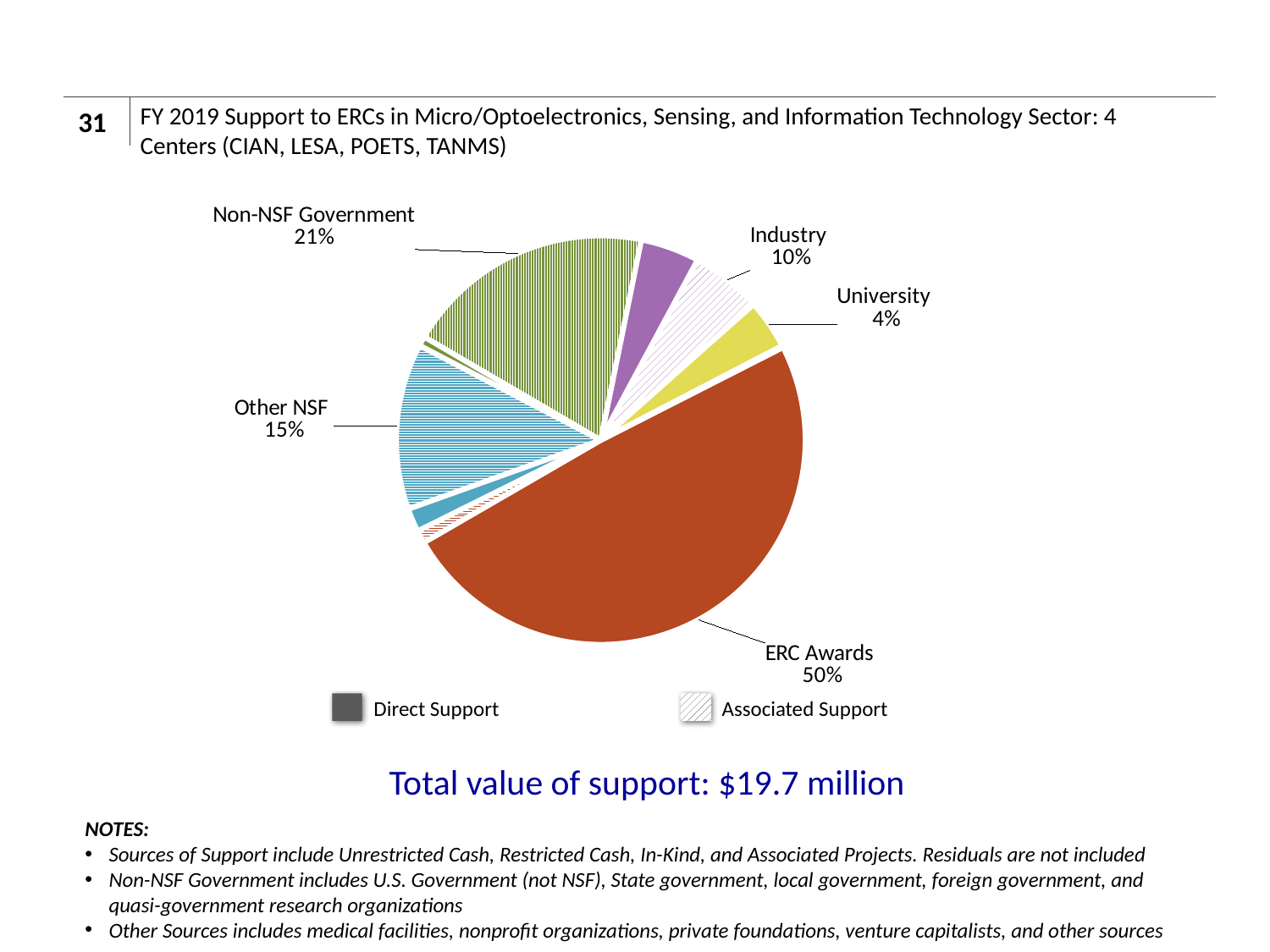
What is the total value of support stated below the chart? $19.7 million What percentage of support is from Non-NSF Government? 21% Which labeled source accounts for the largest share of support? ERC Awards How many percentage points larger is the ERC Awards share than the Non-NSF Government share? 29 How many entries does the legend list? 2 What share of support comes from ERC Awards? 50% Which labeled source accounts for the smallest share of support? University What percentage of support is from University? 4% What percentage of support is from Other NSF? 15% What type of chart is shown on the slide? pie chart Which is larger, the share from Industry or the share from University? Industry What share of support comes from Industry? 10%